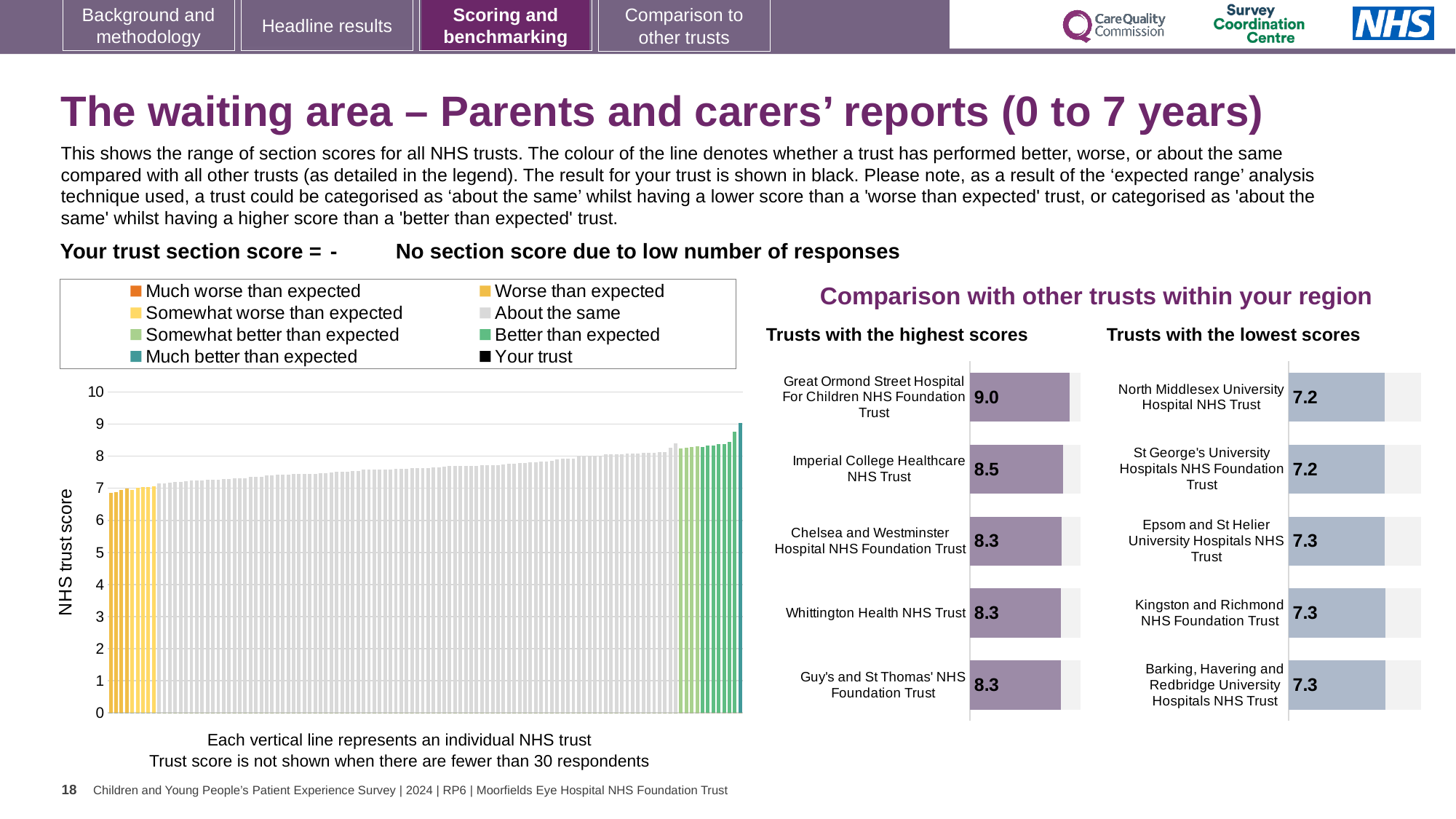
In the 'NHS trust score' chart, is the value of the tallest bar on the far right greater or less than 8? greater How many trusts are listed in the 'Trusts with the lowest scores' chart? 5 In the 'NHS trust score' chart, do the bar heights rise or fall from left to right? Rise In the 'Trusts with the highest scores' chart, what is the score for Imperial College Healthcare NHS Trust? 8.5 In the 'Trusts with the lowest scores' chart, what is the score for North Middlesex University Hospital NHS Trust? 7.2 In the 'Trusts with the lowest scores' chart, what is the score for Epsom and St Helier University Hospitals NHS Trust? 7.3 In the 'Trusts with the highest scores' chart, what is the score for Great Ormond Street Hospital For Children NHS Foundation Trust? 9.0 What kind of chart is the large chart on the left with the 'NHS trust score' axis? Bar chart How many entries does the legend above the 'NHS trust score' chart list? 8 In the 'Trusts with the highest scores' chart, which has the larger score: Imperial College Healthcare NHS Trust or Whittington Health NHS Trust? Imperial College Healthcare NHS Trust In the 'Trusts with the highest scores' chart, which trust has the highest score? Great Ormond Street Hospital For Children NHS Foundation Trust In the 'Trusts with the highest scores' chart, what is the difference between the scores of Great Ormond Street Hospital For Children NHS Foundation Trust and Imperial College Healthcare NHS Trust? 0.5